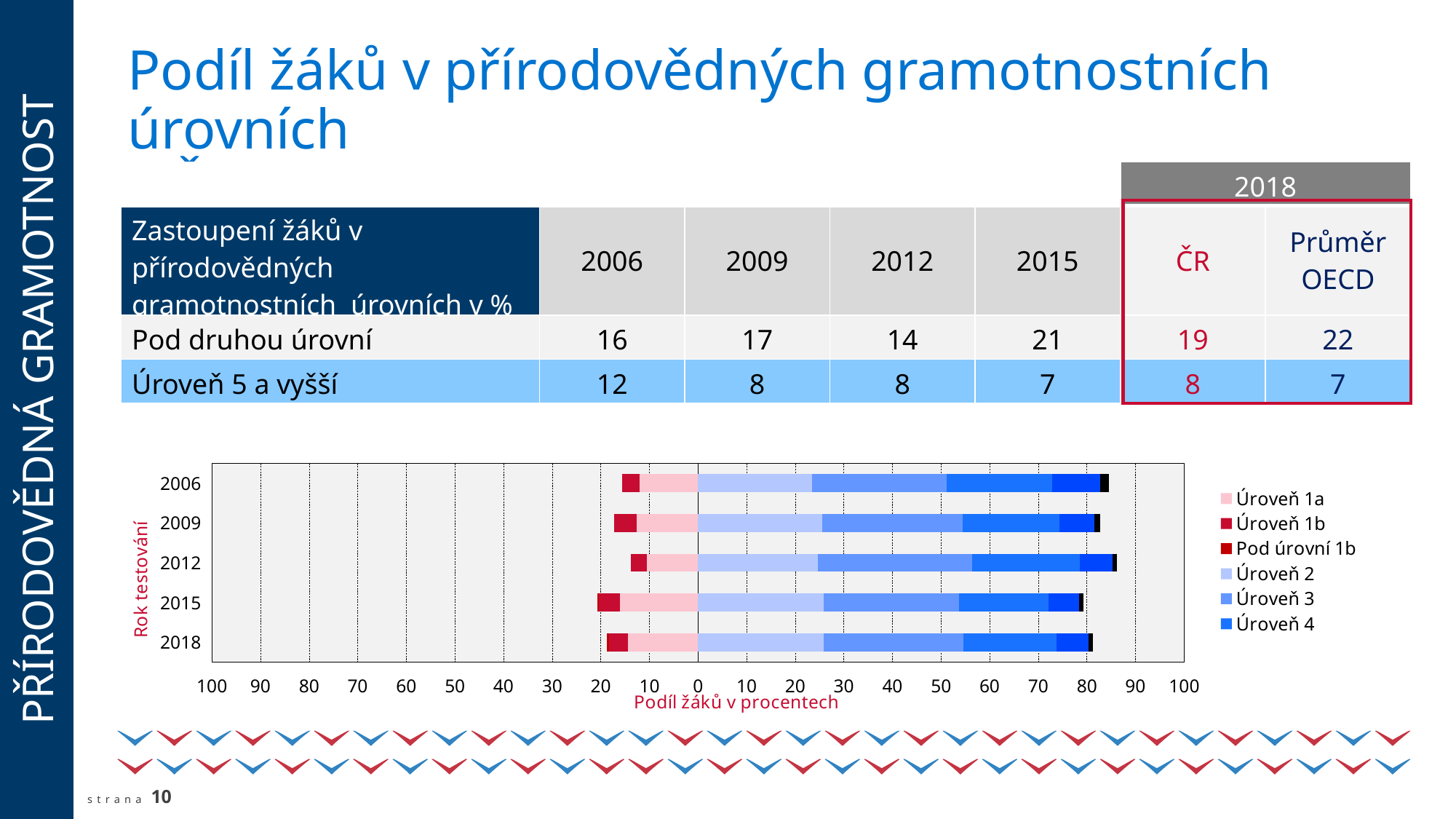
Is the right-hand end of the stacked bar for 2012 greater or less than 90? less What is the title of the chart's vertical axis? Rok testování What is the title of the chart's horizontal axis? Podíl žáků v procentech Which year's stacked bar extends further to the right of zero, 2012 or 2015? 2012 What kind of chart is shown on the slide? Stacked bar chart How many years (categories) are plotted on the chart's vertical axis? 5 Is the right-hand end of the stacked bar for 2006 greater or less than 80? greater Which year is listed at the top of the chart's vertical axis? 2006 How many series does the chart's legend list? 6 Is the right-hand end of the stacked bar for 2012 greater or less than 80? greater Which year's bar extends further to the left of zero, 2015 or 2012? 2015